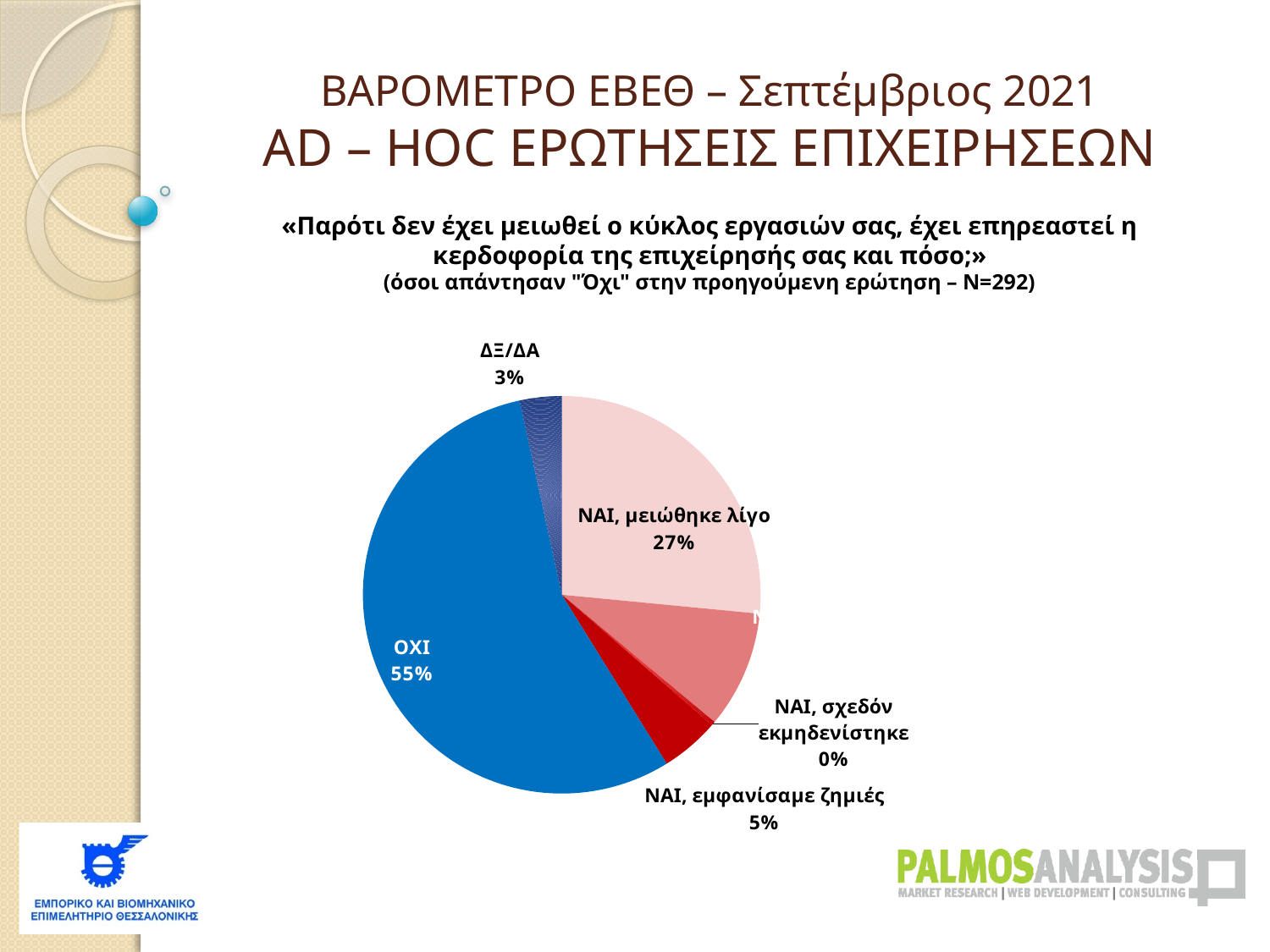
Which labelled response has the smallest share of the pie? ΝΑΙ, σχεδόν εκμηδενίστηκε Which is larger: the share for ΔΞ/ΔΑ or the share for "ΝΑΙ, εμφανίσαμε ζημιές"? ΝΑΙ, εμφανίσαμε ζημιές What colour is the ΟΧΙ slice of the pie? Blue What share of the pie is labelled "ΝΑΙ, μειώθηκε λίγο"? 27% How many percentage points larger is the ΟΧΙ share than the "ΝΑΙ, μειώθηκε λίγο" share? 28 percentage points What is the sample size (N) stated in the chart's subtitle? N=292 What percentage of respondents answered ΟΧΙ? 55% What percentage is shown for ΔΞ/ΔΑ? 3% Which response has the largest share of the pie? ΟΧΙ What percentage is shown for "ΝΑΙ, σχεδόν εκμηδενίστηκε"? 0% What percentage is shown for "ΝΑΙ, εμφανίσαμε ζημιές"? 5% What type of chart is shown on the slide? Pie chart